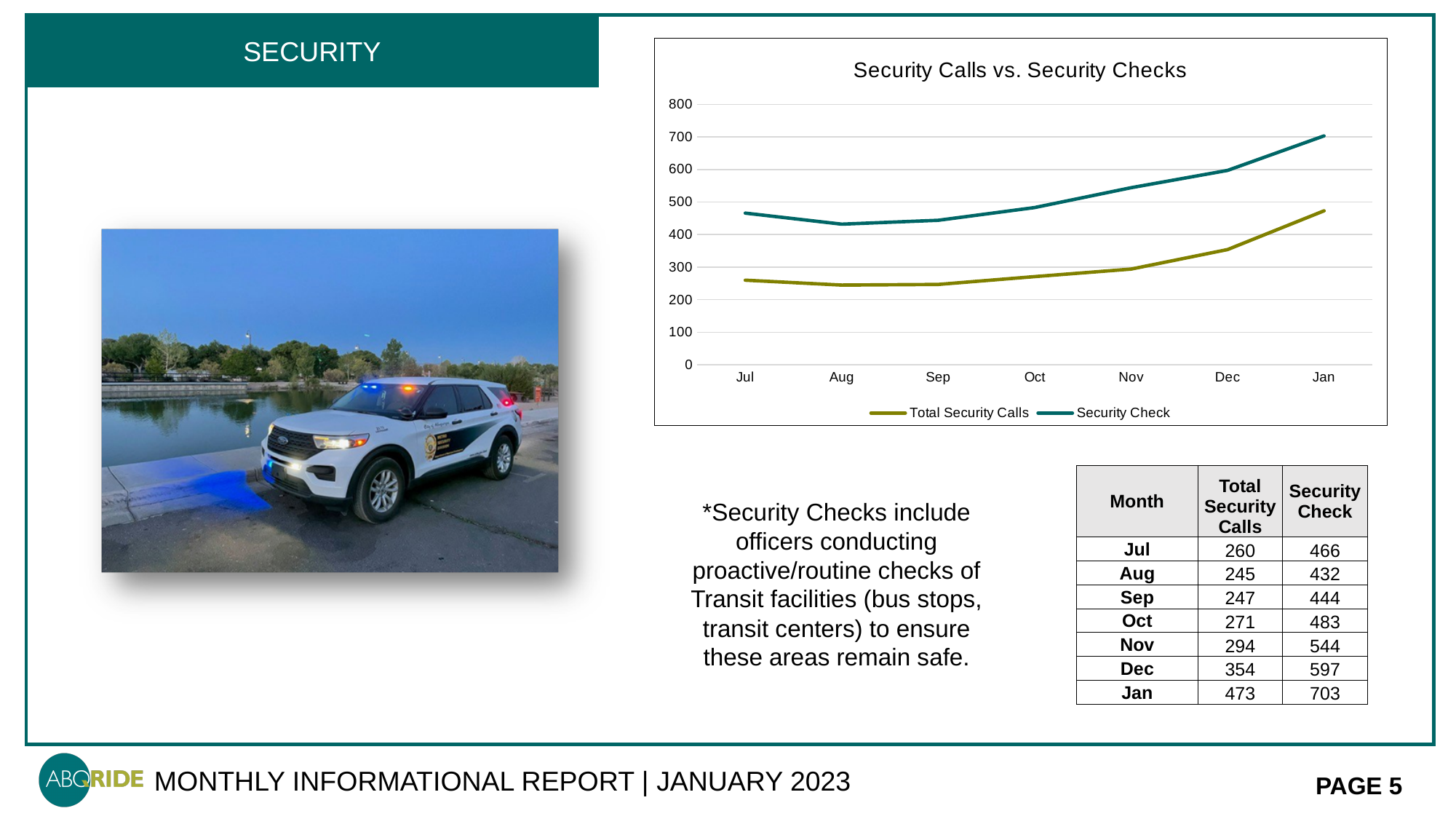
Which month has the highest Security Check value? Jan How many months are plotted along the x axis of the chart? 7 Which is larger in Oct, Total Security Calls or Security Check? Security Check According to the table, what is the Security Check value for Jan? 703 What type of chart is shown on the slide? line chart How many series does the chart legend list? 2 What is the title of the chart? Security Calls vs. Security Checks Is the Security Check value for Nov greater or less than 500? greater What is the difference between Security Check and Total Security Calls in Dec? 243 Do the Security Check values rise or fall from Sep to Jan? rise Which month has the lowest Total Security Calls value? Aug According to the table, what is the Total Security Calls value for Aug? 245